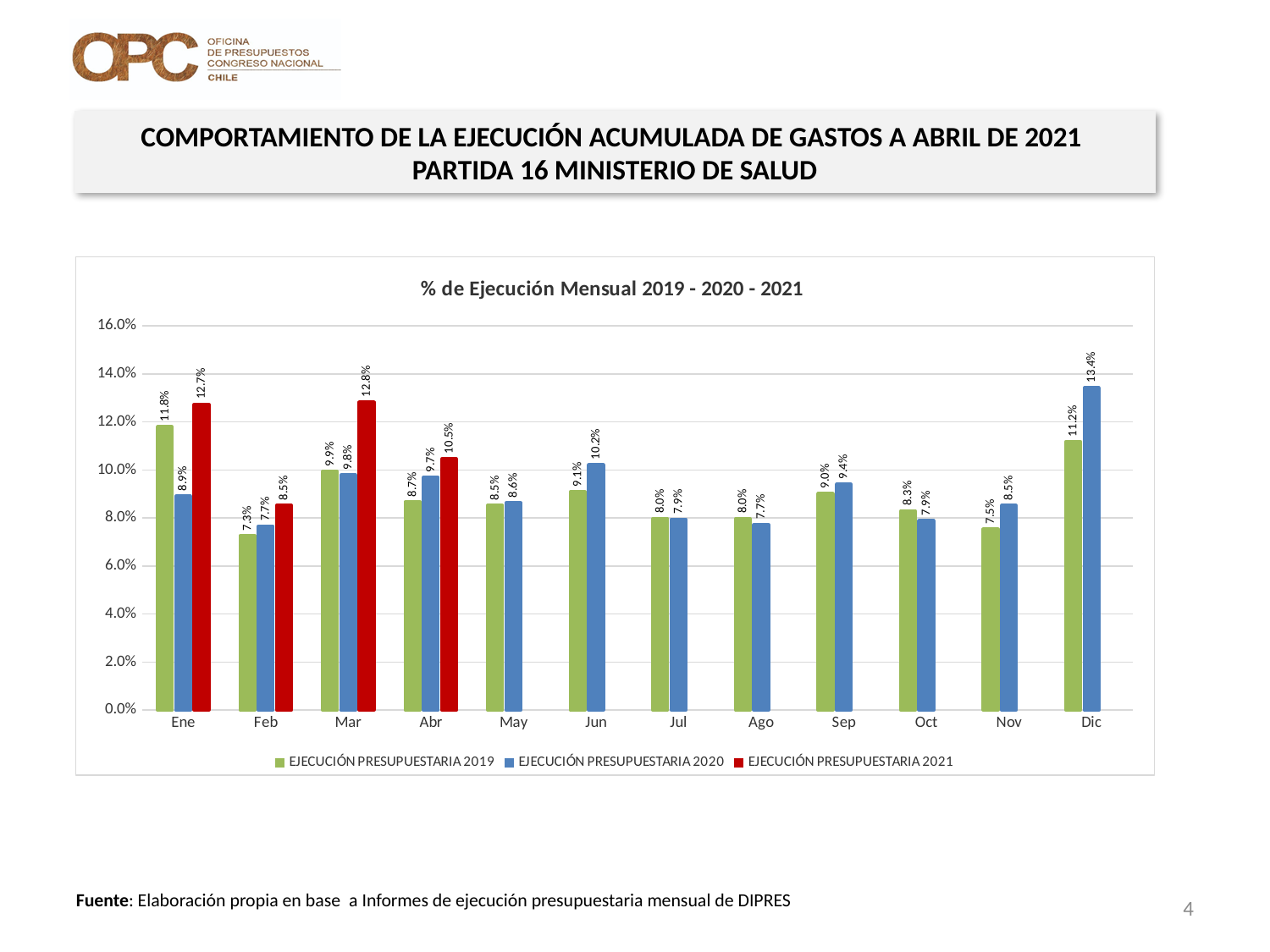
Is the EJECUCIÓN PRESUPUESTARIA 2020 value for Nov greater or less than 10.0%? less What type of chart is shown on the slide? Bar chart What is the value for EJECUCIÓN PRESUPUESTARIA 2021 in Mar? 12.8% In which month is the EJECUCIÓN PRESUPUESTARIA 2020 value highest? Dic What is the value for EJECUCIÓN PRESUPUESTARIA 2020 in Dic? 13.4% What is the value for EJECUCIÓN PRESUPUESTARIA 2021 in Abr? 10.5% In which month is the EJECUCIÓN PRESUPUESTARIA 2019 value lowest? Feb Which is larger in Jun: the EJECUCIÓN PRESUPUESTARIA 2019 value or the EJECUCIÓN PRESUPUESTARIA 2020 value? EJECUCIÓN PRESUPUESTARIA 2020 What is the difference between the EJECUCIÓN PRESUPUESTARIA 2021 and EJECUCIÓN PRESUPUESTARIA 2019 values in Ene? 0.9% How many months are shown on the x axis? 12 How many series does the legend list? 3 What is the value for EJECUCIÓN PRESUPUESTARIA 2019 in Ene? 11.8%